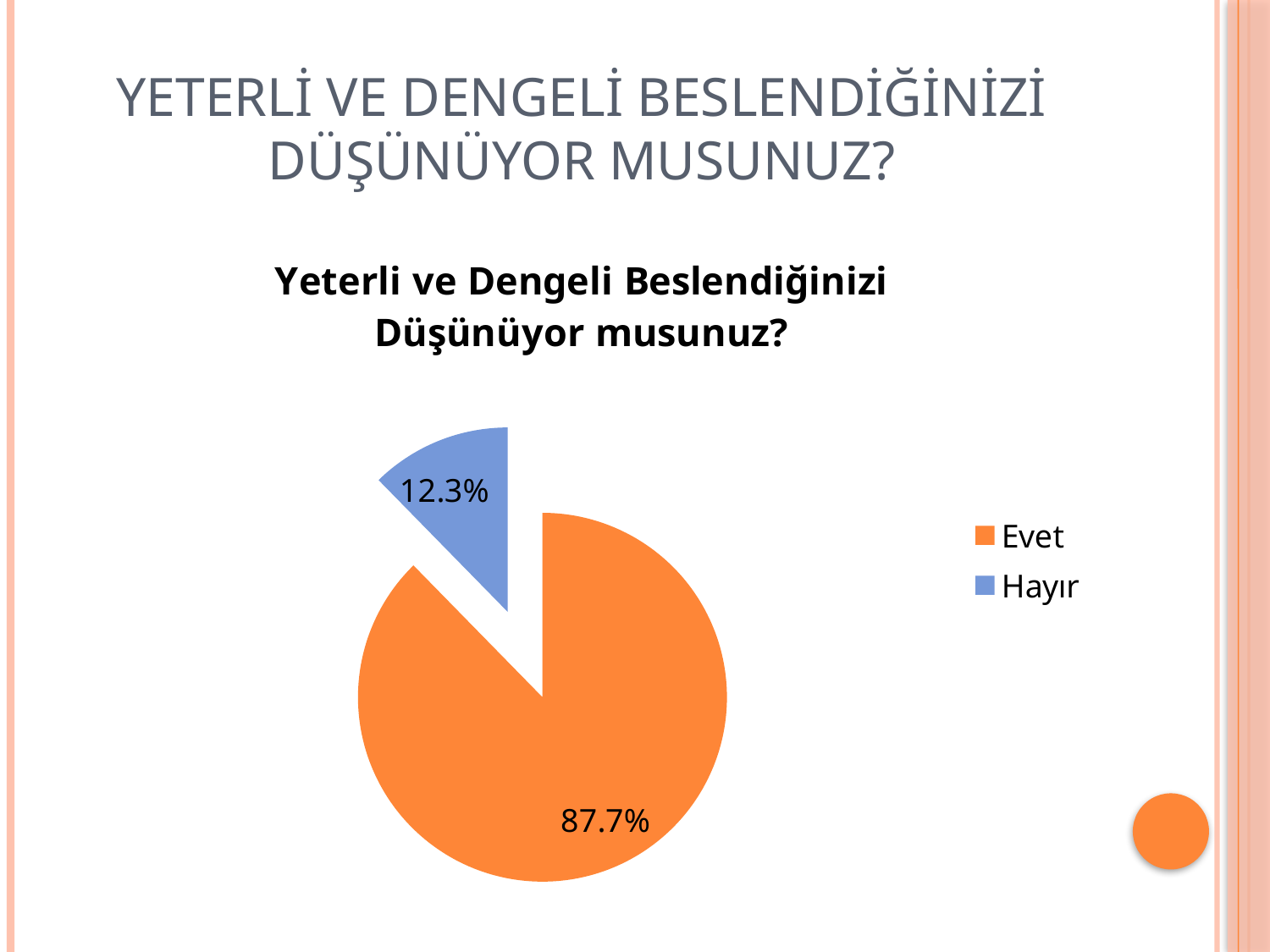
How many entries does the legend list? 2 What percentage of the pie chart is labelled Evet? 87.7% What is the title of the chart? Yeterli ve Dengeli Beslendiğinizi Düşünüyor musunuz? Which category has the largest share of the pie chart? Evet Which slice is larger, Evet or Hayır? Evet What type of chart is shown on the slide? Pie chart How many slices does the pie chart have? 2 Which category has the smallest share of the pie chart? Hayır What percentage of the pie chart is labelled Hayır? 12.3% What is the difference in percentage points between the Evet and Hayır slices? 75.4 What colour is the Hayır slice of the pie chart? Blue